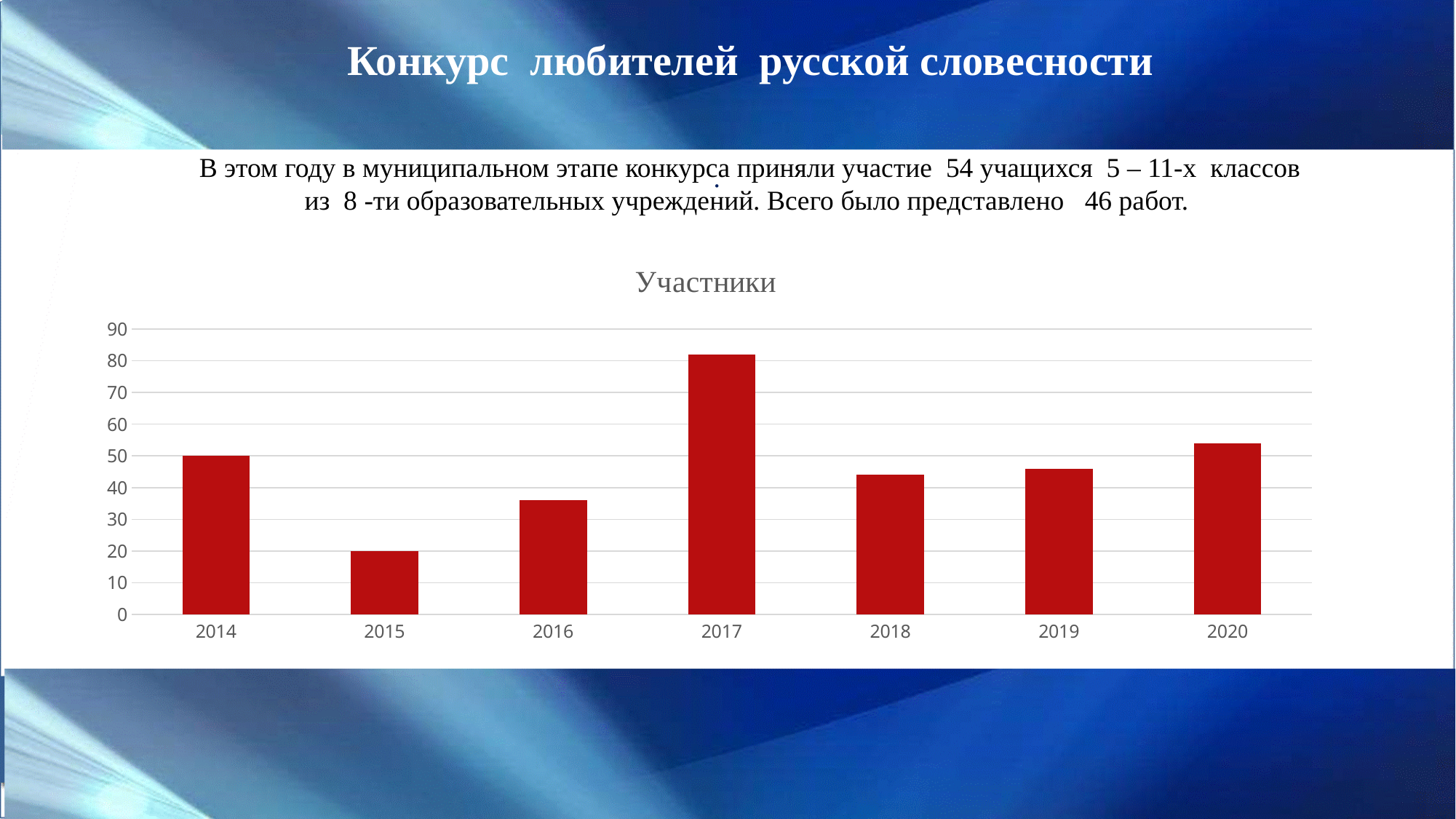
What is the value for 2014? 50 What is the title of the chart? Участники Which year has the highest value? 2017 What is the value for 2015? 20 What kind of chart is this? bar chart Is the value for 2020 greater or less than 50? greater How many years are shown on the x axis? 7 Which year has the lowest value? 2015 What is the difference between the values for 2014 and 2015? 30 Is the value for 2016 greater or less than 40? less Is the value for 2017 greater or less than 80? greater Which is larger, the value for 2017 or the value for 2014? 2017